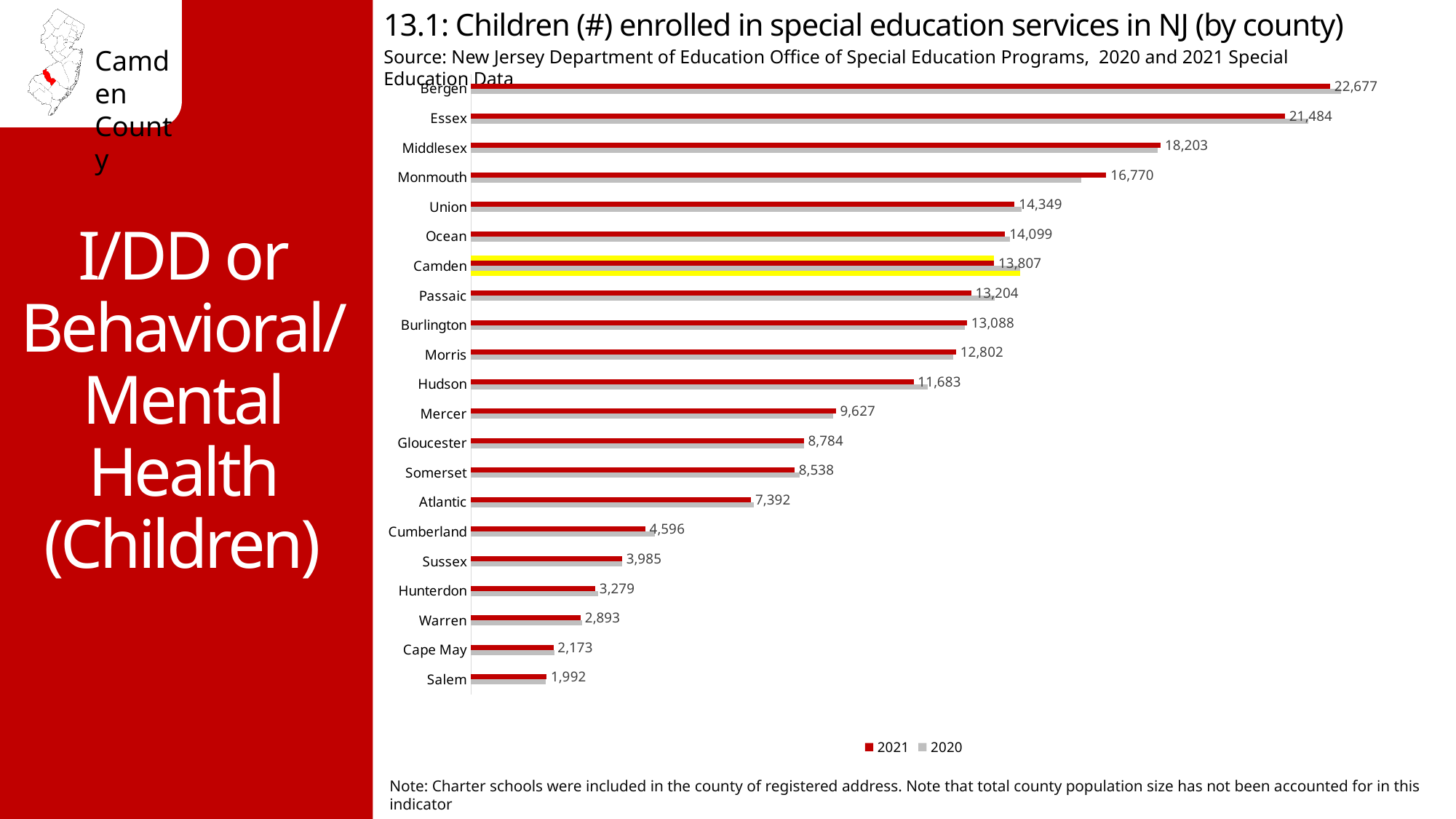
What is the difference between the 2021 values for Camden and Passaic? 603 What kind of chart is shown on the slide? Bar chart What is the 2021 value for Camden? 13,807 How many series does the legend list? 2 What is the 2021 value for Cumberland? 4,596 Which county has the lowest 2021 value? Salem How many counties are shown in the chart? 21 Which county's bars are highlighted in yellow? Camden What is the 2021 value for Bergen? 22,677 Which has the larger 2021 value, Gloucester or Somerset? Gloucester Which county has the highest 2021 value? Bergen What is the difference between the 2021 values for Bergen and Essex? 1,193